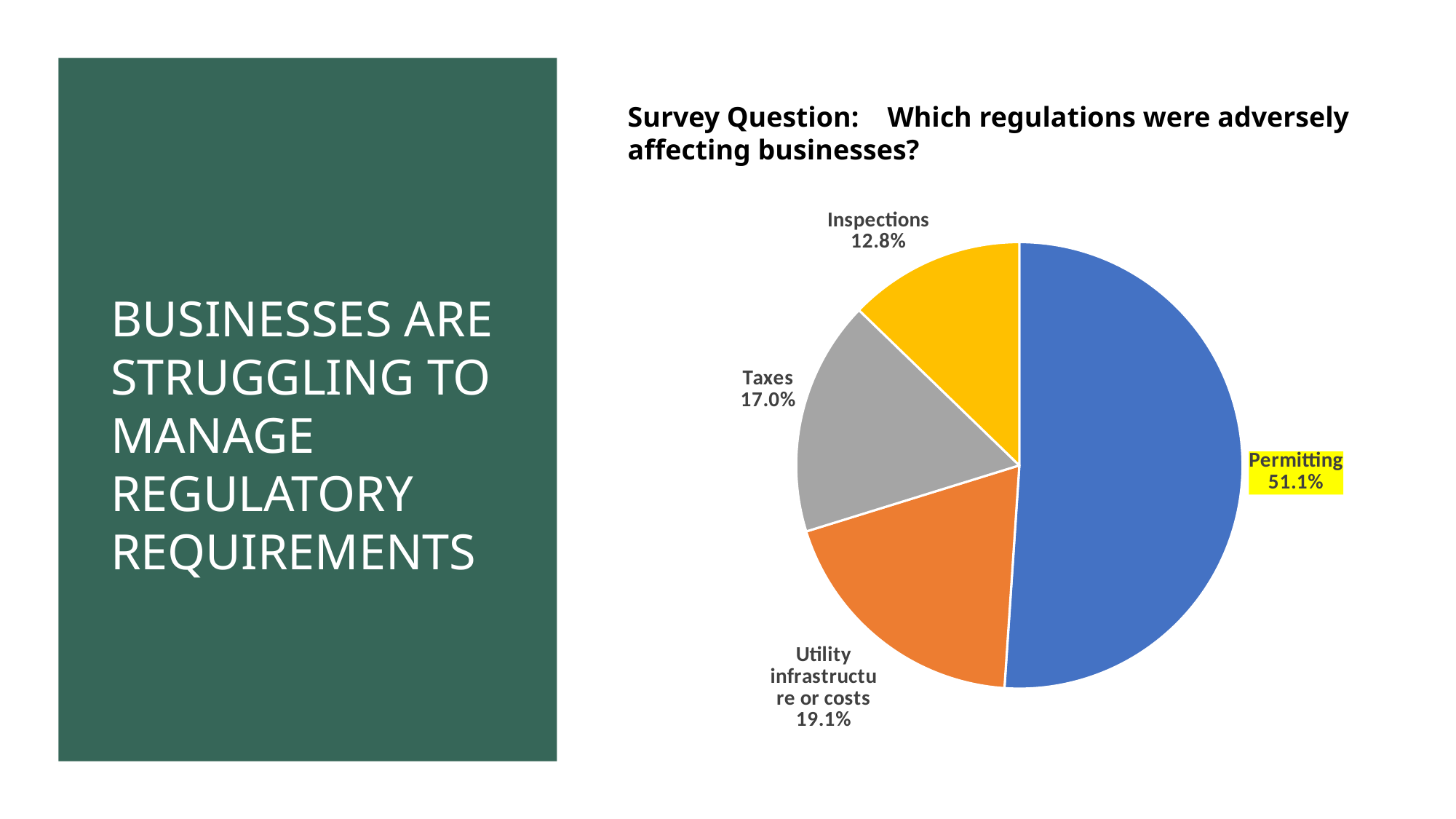
Which category has the largest slice of the pie? Permitting What is the value shown for Inspections? 12.8% What is the difference between the Utility infrastructure or costs and Inspections values? 6.3% Which is larger, Utility infrastructure or costs or Taxes? Utility infrastructure or costs Which category has the smallest slice of the pie? Inspections How many categories are shown in the pie chart? 4 What is the value shown for Taxes? 17.0% Which category's label is highlighted in yellow on the chart? Permitting What is the value shown for Utility infrastructure or costs? 19.1% What type of chart is shown on the slide? pie chart What share of the pie does Permitting account for? 51.1% What is the difference between the Permitting and Taxes values? 34.1%